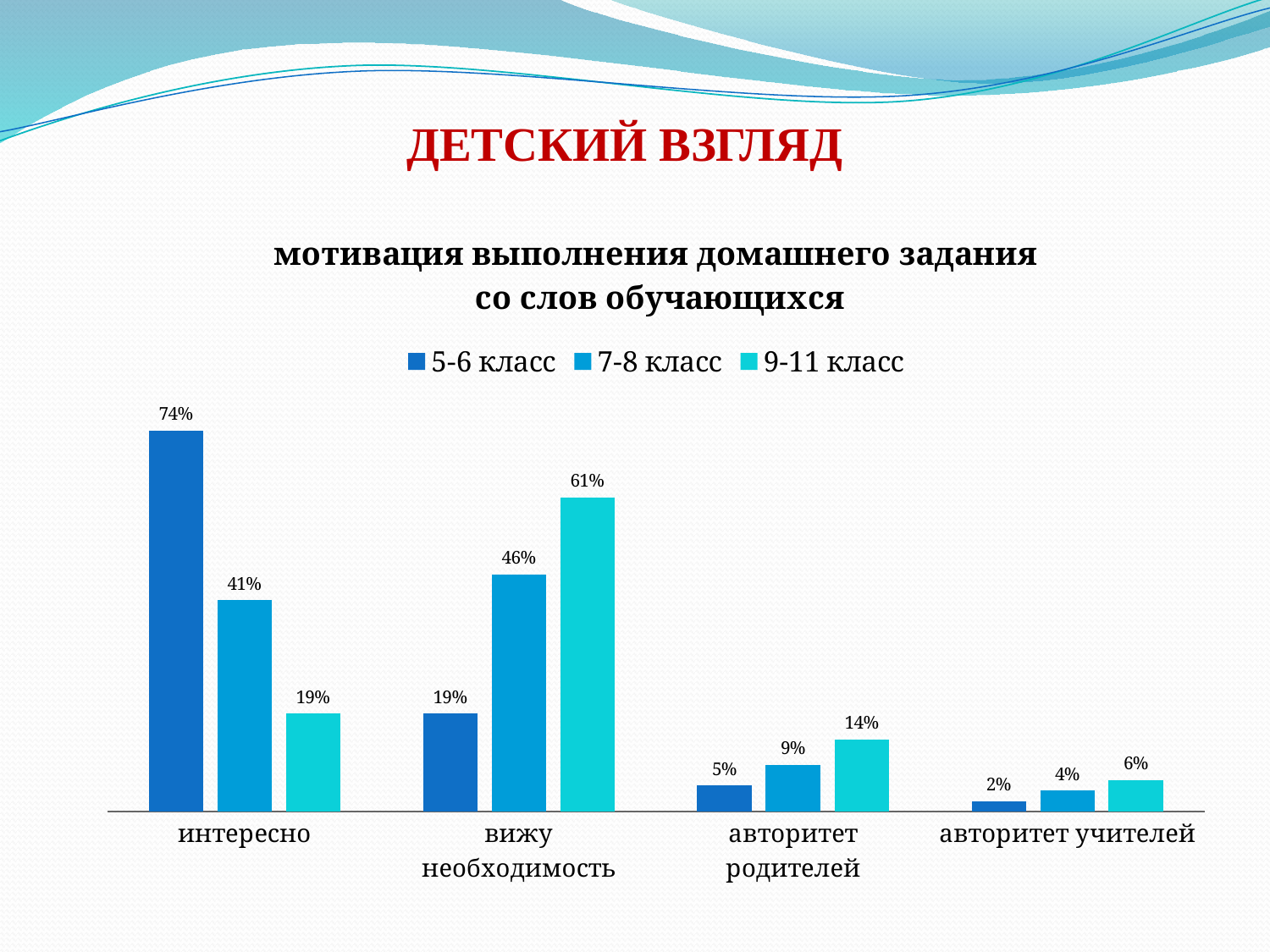
What is the difference between the 5-6 класс and 9-11 класс values in the интересно category? 55% Which is larger in the вижу необходимость category: the value for 7-8 класс or for 9-11 класс? 9-11 класс Which category has the lowest value for 7-8 класс? авторитет учителей How many series does the legend list? 3 How many categories are shown on the x axis? 4 What is the value for 5-6 класс in the интересно category? 74% What is the value for 5-6 класс in the авторитет учителей category? 2% Which category has the highest value for 9-11 класс? вижу необходимость What kind of chart is shown on the slide? bar chart What is the title of the chart? мотивация выполнения домашнего задания со слов обучающихся What is the value for 7-8 класс in the авторитет родителей category? 9% What is the value for 9-11 класс in the вижу необходимость category? 61%